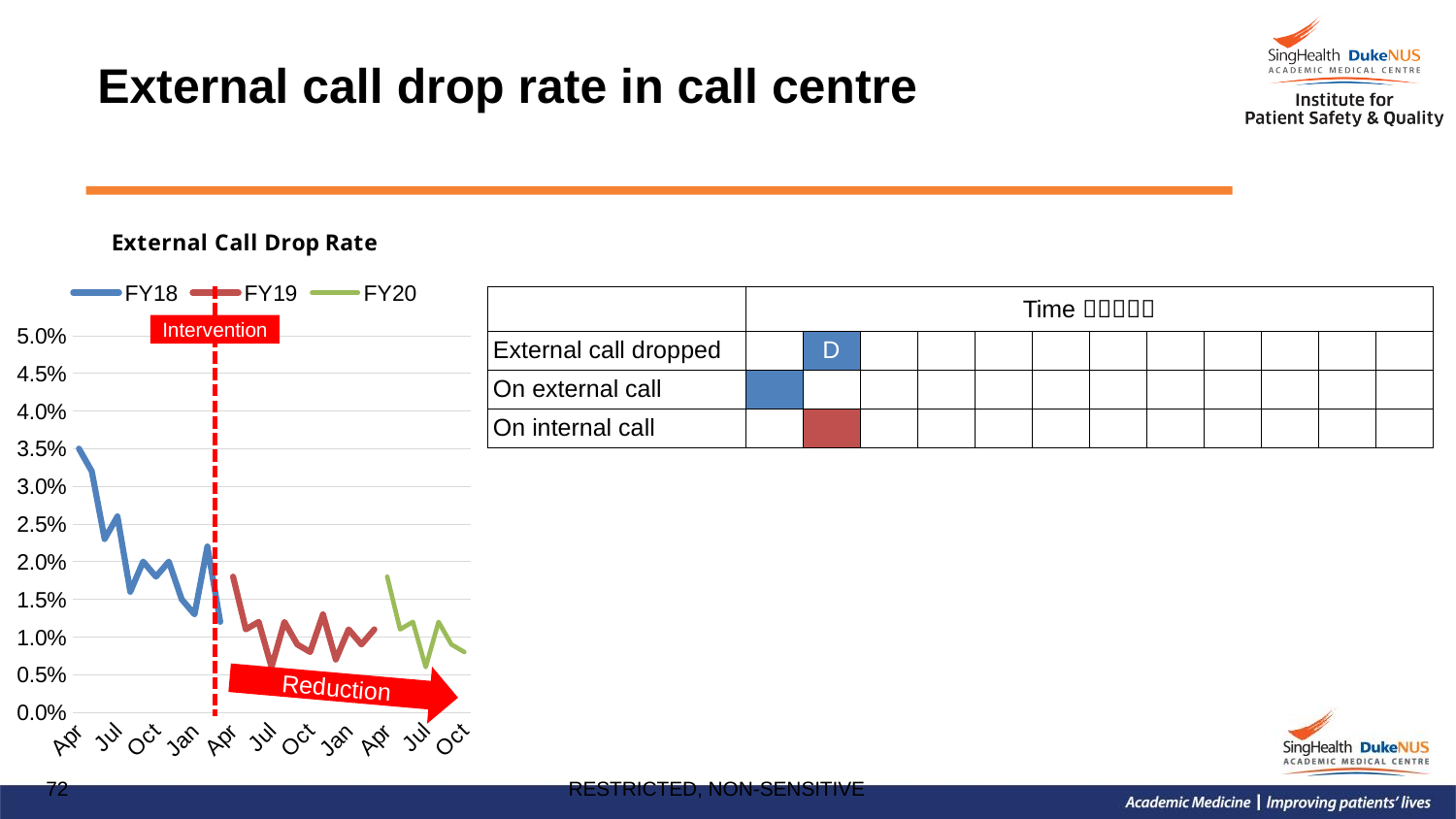
Is the last FY20 value (Oct) in the External Call Drop Rate chart greater or less than 1.5%? less What kind of chart is the External Call Drop Rate chart? line chart Is the first FY18 value (Apr) in the External Call Drop Rate chart greater or less than 3.0%? greater Which series in the External Call Drop Rate chart reaches the highest call drop rate? FY18 How many series does the legend of the External Call Drop Rate chart list? 3 What is the highest value shown on the vertical axis of the External Call Drop Rate chart? 5.0% In the External Call Drop Rate chart, which is larger: the first FY18 value or the first FY20 value? the first FY18 value Is the highest FY19 value in the External Call Drop Rate chart greater or less than 2.0%? less What is the title of the chart on the slide? External Call Drop Rate How many month labels are shown on the horizontal axis of the External Call Drop Rate chart? 11 What are the series names in the legend of the External Call Drop Rate chart? FY18, FY19, FY20 Does the FY18 line in the External Call Drop Rate chart generally rise or fall from Apr to the following Apr? fall